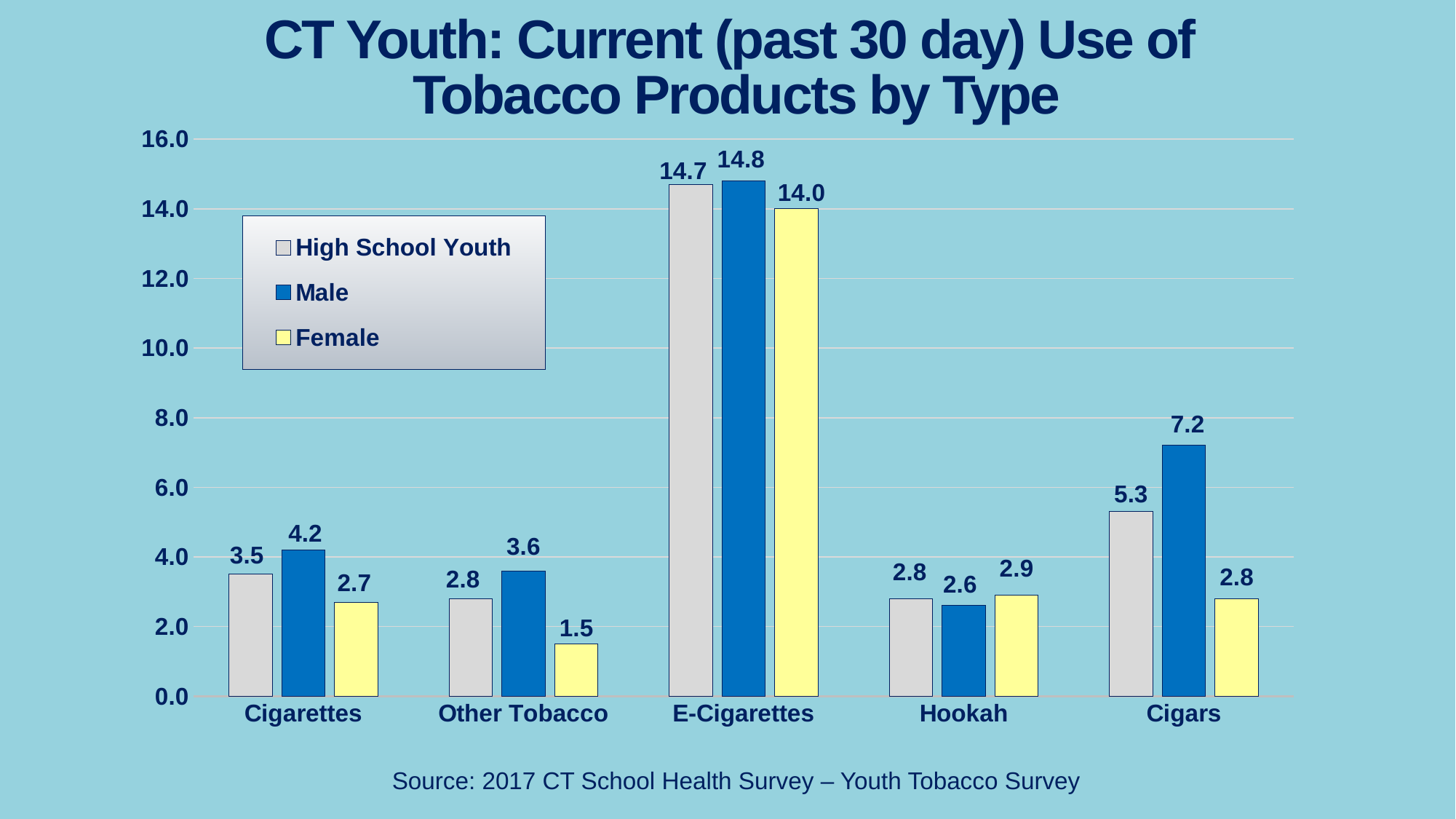
Which category has the highest Female value? E-Cigarettes What kind of chart is shown on the slide? Bar chart Which is larger for Hookah, the Male value or the Female value? Female Which category has the lowest Male value? Hookah What is the Female value for Other Tobacco? 1.5 Is the High School Youth value for E-Cigarettes greater or less than 14.0? greater What is the difference between the Male and Female values for Cigars? 4.4 How many tobacco product categories are shown on the x axis? 5 How many series does the legend list? 3 What is the source cited below the chart? 2017 CT School Health Survey – Youth Tobacco Survey What is the High School Youth value for Cigars? 5.3 What is the Male value for E-Cigarettes? 14.8